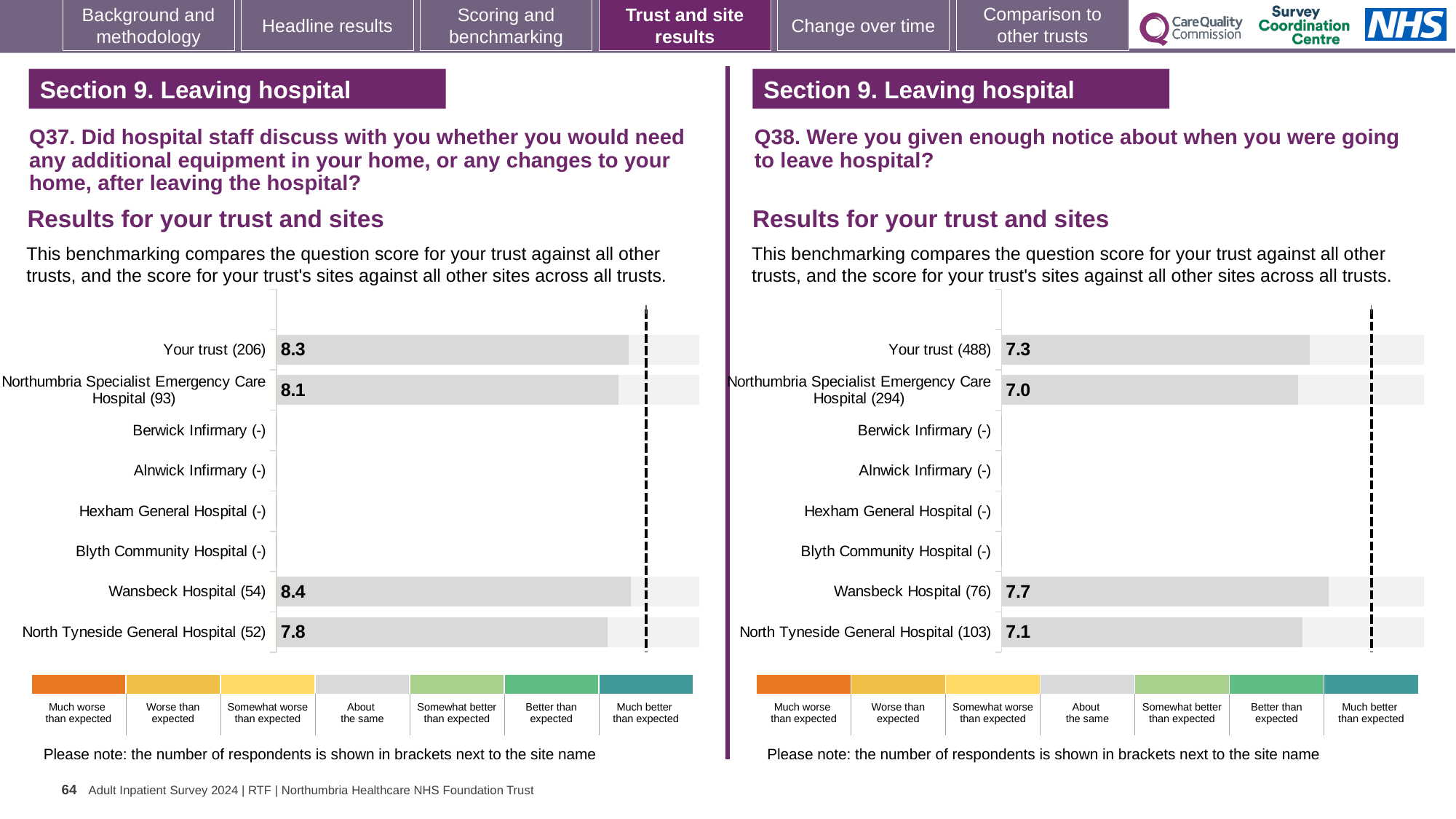
On the Q38 chart (right), what is the difference between the scores for Wansbeck Hospital and Northumbria Specialist Emergency Care Hospital? 0.7 How many respondents are shown in brackets for Your trust on the Q38 chart (right)? 488 On the Q38 chart (right), what is the score for Your trust? 7.3 On the Q37 chart (left), which site has the lowest score shown? North Tyneside General Hospital On the Q38 chart (right), which site has the highest score shown? Wansbeck Hospital How many sites on the Q37 chart (left) have a score bar displayed? 4 What type of chart is used on the Q38 chart (right)? Bar chart On the Q38 chart (right), what is the score for Northumbria Specialist Emergency Care Hospital? 7.0 On the Q37 chart (left), what is the difference between the scores for Wansbeck Hospital and North Tyneside General Hospital? 0.6 On the Q38 chart (right), which is larger: the score for Your trust or the score for North Tyneside General Hospital? Your trust On the Q37 chart (left), what is the score for Wansbeck Hospital? 8.4 On the Q37 chart (left), what is the score for Your trust? 8.3